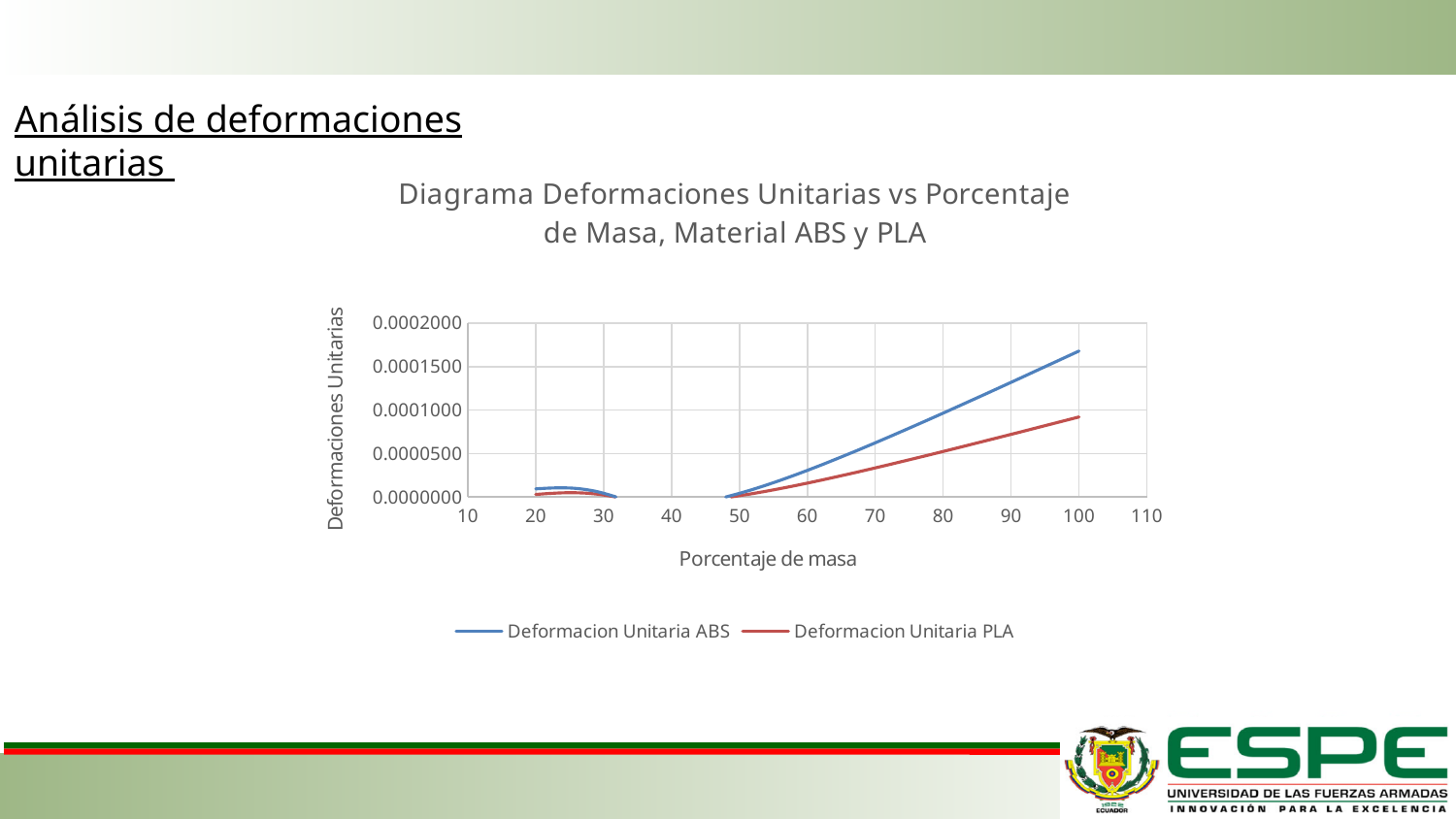
Is the value for Deformacion Unitaria PLA at a mass percentage of 100 greater or less than 0.0001000? less What is the label of the x axis? Porcentaje de masa At a mass percentage of 100, which series has the larger value, Deformacion Unitaria ABS or Deformacion Unitaria PLA? Deformacion Unitaria ABS How many series does the legend list? 2 Which series reaches the highest value on the chart? Deformacion Unitaria ABS What is the title of the chart? Diagrama Deformaciones Unitarias vs Porcentaje de Masa, Material ABS y PLA Is the value for Deformacion Unitaria ABS at a mass percentage of 80 greater or less than 0.0000500? greater Do the values for Deformacion Unitaria PLA rise or fall as the mass percentage increases from 50 to 100? rise Do the values for Deformacion Unitaria ABS rise or fall as the mass percentage increases from 50 to 100? rise Is the value for Deformacion Unitaria ABS at a mass percentage of 100 greater or less than 0.0001500? greater What kind of chart is shown on the slide? line chart